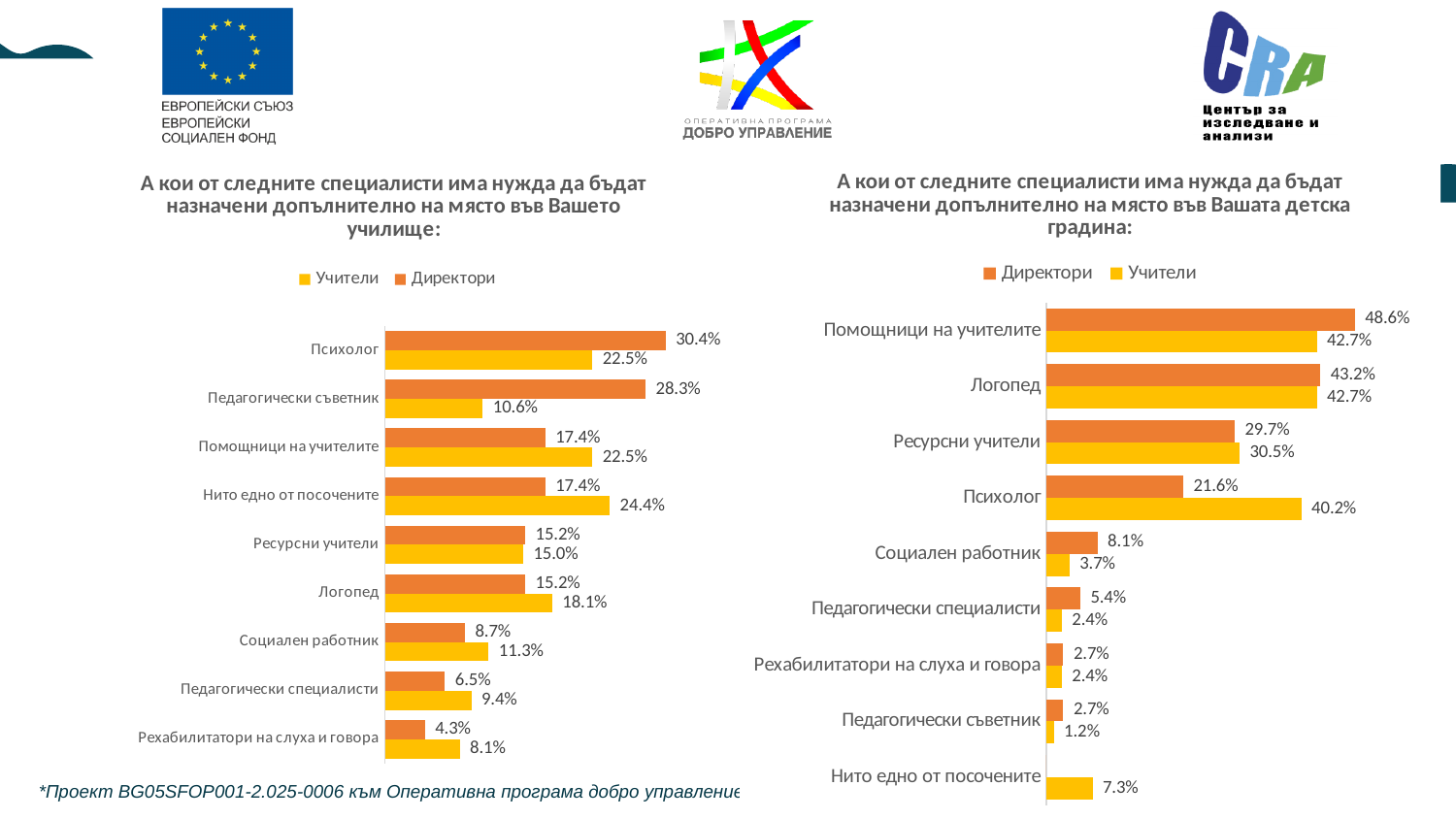
In the right chart (about the kindergarten), which category has the lowest value for Учители? Педагогически съветник What type of chart is the left chart (about the school)? Bar chart In the left chart (about the school), what is the value for Учители for Педагогически съветник? 10.6% In the right chart (about the kindergarten), which is larger for Психолог: the Директори value or the Учители value? Учители In the left chart (about the school), what is the difference between the Директори and Учители values for Педагогически съветник? 17.7% In the left chart (about the school), which category has the highest value for Директори? Психолог In the right chart (about the kindergarten), what is the value for Директори for Помощници на учителите? 48.6% In the right chart (about the kindergarten), what is the difference between the Директори and Учители values for Социален работник? 4.4% How many series does the legend of the right chart (about the kindergarten) list? 2 In the right chart (about the kindergarten), what is the value for Учители for Психолог? 40.2% How many categories are shown in the left chart (about the school)? 9 In the left chart (about the school), what is the value for Директори for Психолог? 30.4%